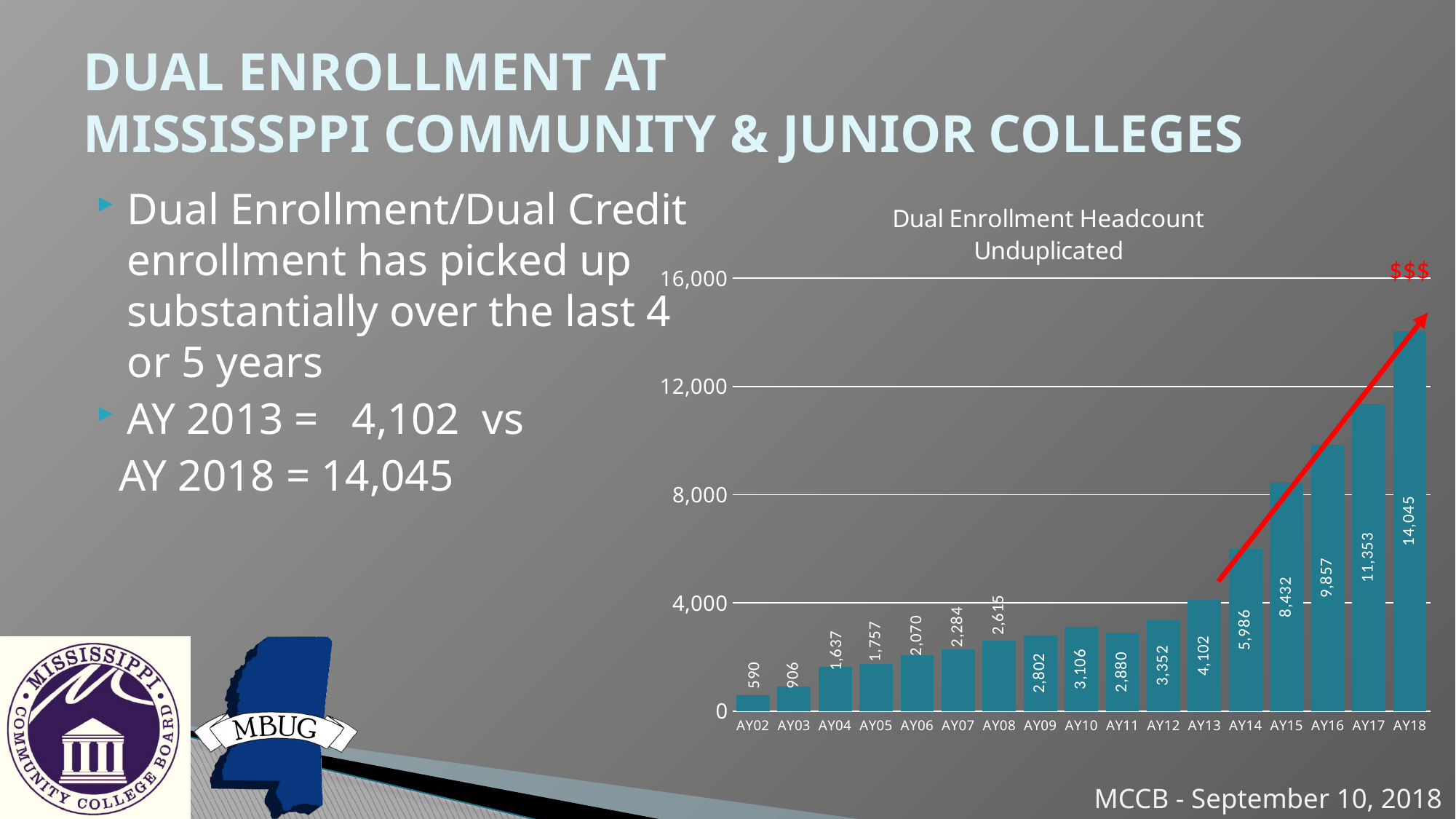
What is the difference between the AY18 and AY13 values in the chart? 9,943 Which academic year has the highest headcount in the chart? AY18 What is the title of the chart on the slide? Dual Enrollment Headcount Unduplicated What is the value for AY02 in the Dual Enrollment Headcount Unduplicated chart? 590 Which academic year has the lowest headcount in the chart? AY02 What is the value for AY10 in the Dual Enrollment Headcount Unduplicated chart? 3,106 How many academic years are shown on the x axis of the chart? 17 Is the value for AY16 greater or less than 8,000? greater Which is larger in the chart, the value for AY10 or the value for AY11? AY10 What is the value for AY13 in the Dual Enrollment Headcount Unduplicated chart? 4,102 What is the value for AY18 in the Dual Enrollment Headcount Unduplicated chart? 14,045 What kind of chart is shown on the slide? bar chart